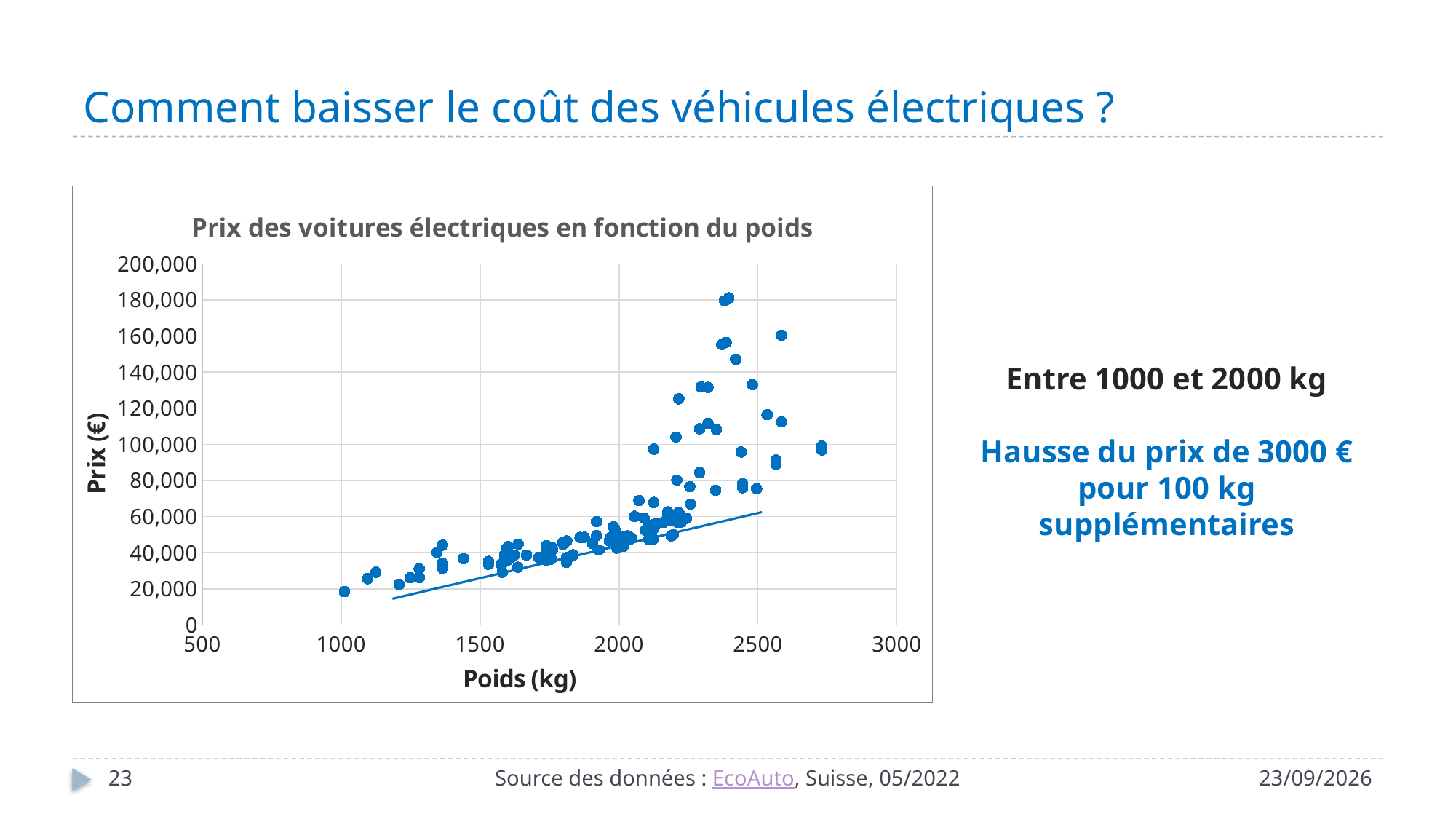
What kind of chart is shown on the slide? scatter chart What is the highest value shown on the y axis of the chart? 200,000 Which weight has the higher-priced points: around 1000 kg or around 2400 kg? around 2400 kg Do the prices generally rise or fall as the weight increases along the x axis? rise What is the title of the chart? Prix des voitures électriques en fonction du poids Is the price of the point at about 2500 kg near the top of the cluster greater or less than 120,000? greater Is the price of the highest point on the chart greater or less than 160,000? greater Are the prices of the points at about 1500 kg greater or less than 60,000? less What is the label of the x axis of the chart? Poids (kg)